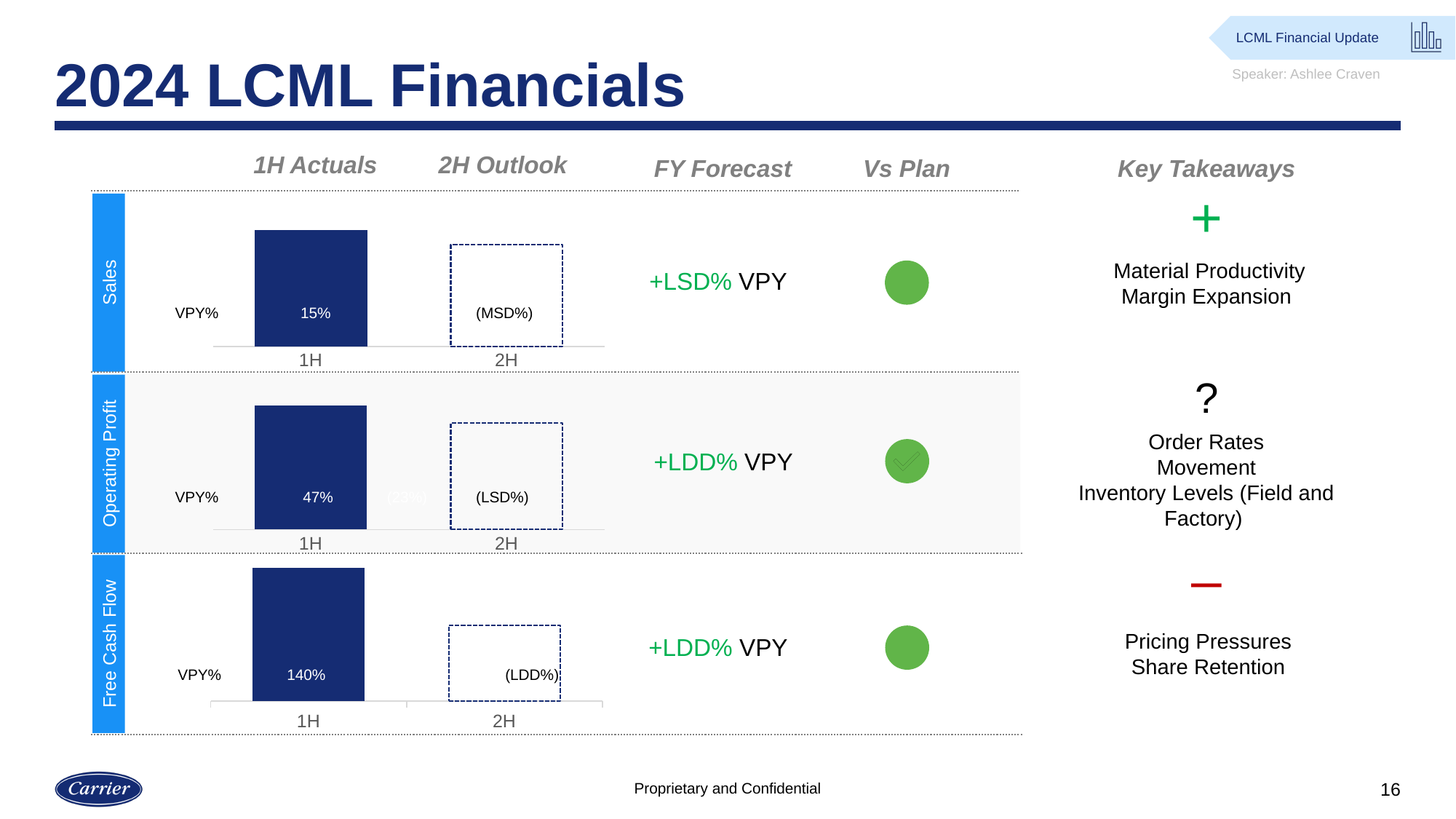
What is the difference between the Free Cash Flow 1H VPY% and the Sales 1H VPY%? 125 percentage points Which is larger: the Operating Profit 1H VPY% or the Sales 1H VPY%? Operating Profit 1H VPY% In the Sales chart, what label is shown for the 2H outlook? (MSD%) In the Sales chart, what is the 1H VPY% value? 15% In the Free Cash Flow chart, what is the 1H VPY% value? 140% In the Free Cash Flow chart, what label is shown for the 2H outlook? (LDD%) How many periods are shown on the x axis of the Sales chart? 2 In the Operating Profit chart, what label is shown for the 2H outlook? (LSD%) In the Operating Profit chart, what is the 1H VPY% value? 47% Across the three charts, which metric has the lowest 1H VPY% value? Sales Across the three charts, which metric has the highest 1H VPY% value? Free Cash Flow What kind of chart is used for the Sales, Operating Profit and Free Cash Flow rows? Bar chart